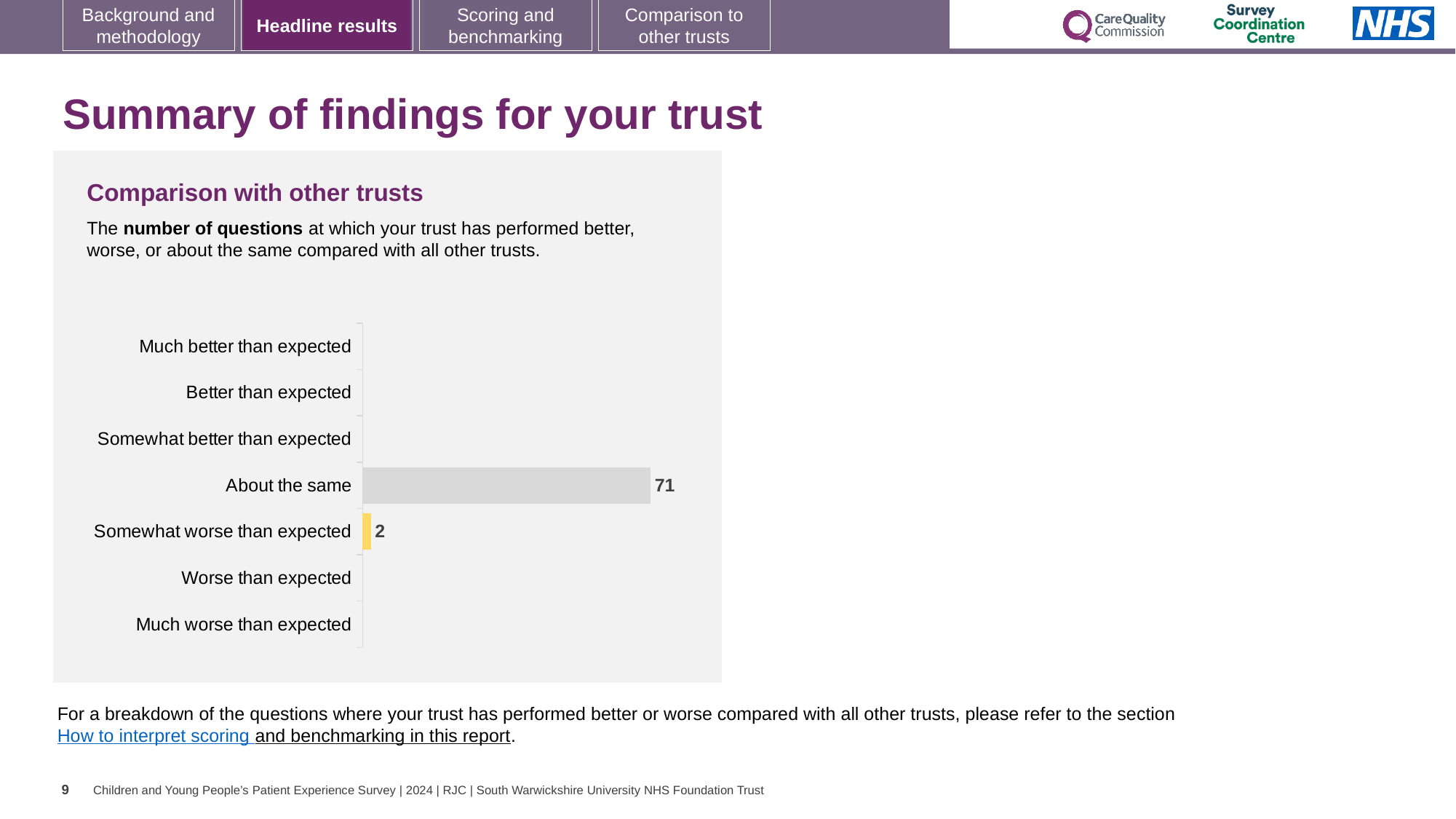
What is the title of the chart? Comparison with other trusts What is the value for 'Somewhat worse than expected'? 2 Which category has the highest value? About the same What kind of chart is shown on the slide? bar chart What is the value for 'About the same'? 71 Which is larger, the value for 'About the same' or the value for 'Somewhat worse than expected'? About the same Of the categories with a visible bar, which has the smallest value? Somewhat worse than expected How many categories are listed on the chart's axis? 7 What is the difference between the values for 'About the same' and 'Somewhat worse than expected'? 69 How many categories have a visible bar on the chart? 2 What colour is the bar for 'Somewhat worse than expected'? yellow